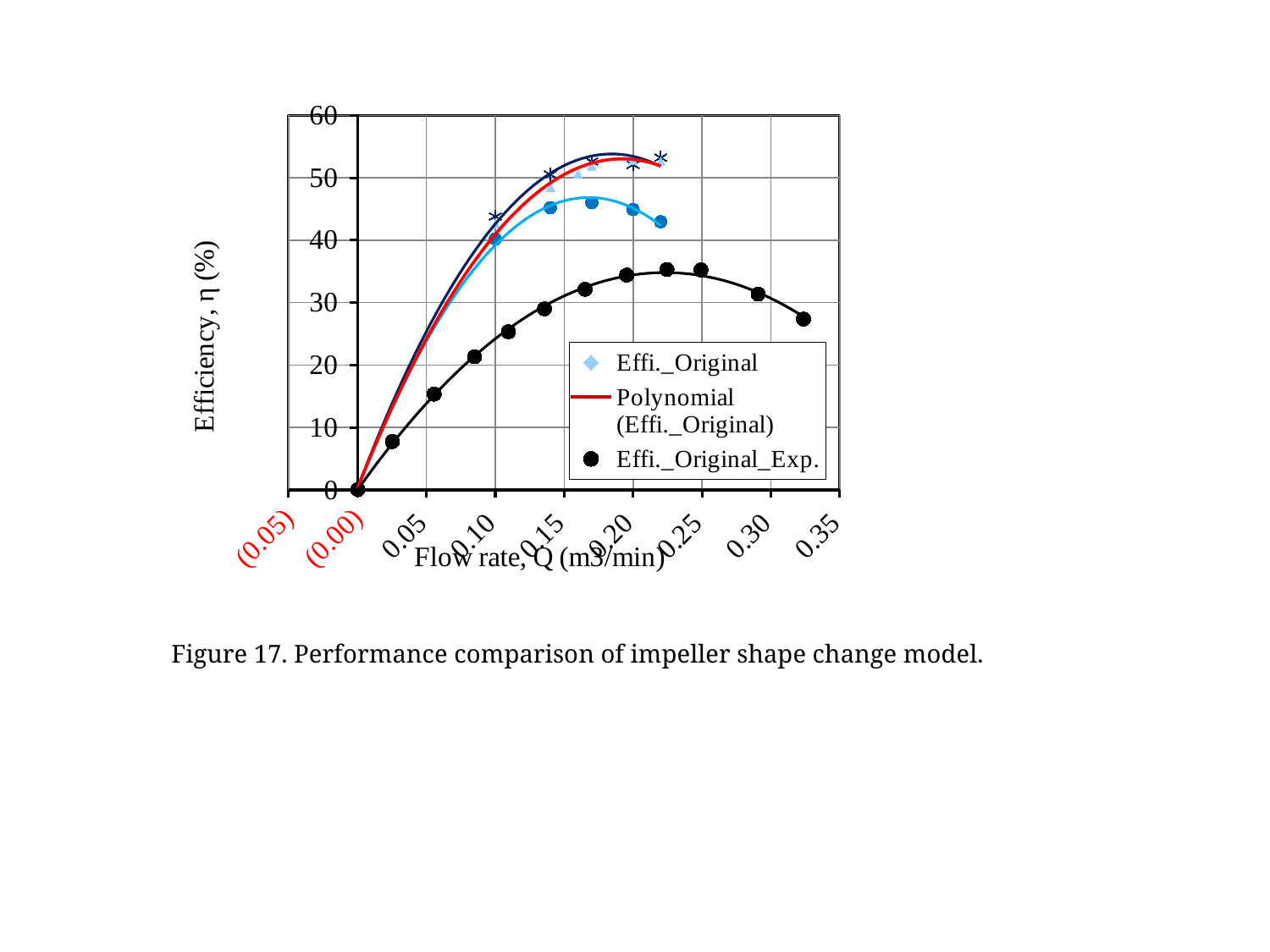
Is the Effi._Original_Exp value at a flow rate of 0.20 greater or less than 30? greater At a flow rate of 0.20, which series has the higher efficiency, Effi._Original or Effi._Original_Exp? Effi._Original Is the Effi._Original_Exp value at a flow rate of 0.05 greater or less than 20? less Is the Effi._Original value at a flow rate of 0.20 greater or less than 40? greater Does the Effi._Original_Exp series rise or fall as the flow rate increases from 0.25 to 0.35? fall What kind of chart is shown on the slide? scatter chart Does the Effi._Original_Exp series rise or fall as the flow rate increases from 0.00 to 0.20? rise What is the label of the y axis? Efficiency, η (%) How many series does the legend list? 3 What is the label of the x axis? Flow rate, Q (m3/min)